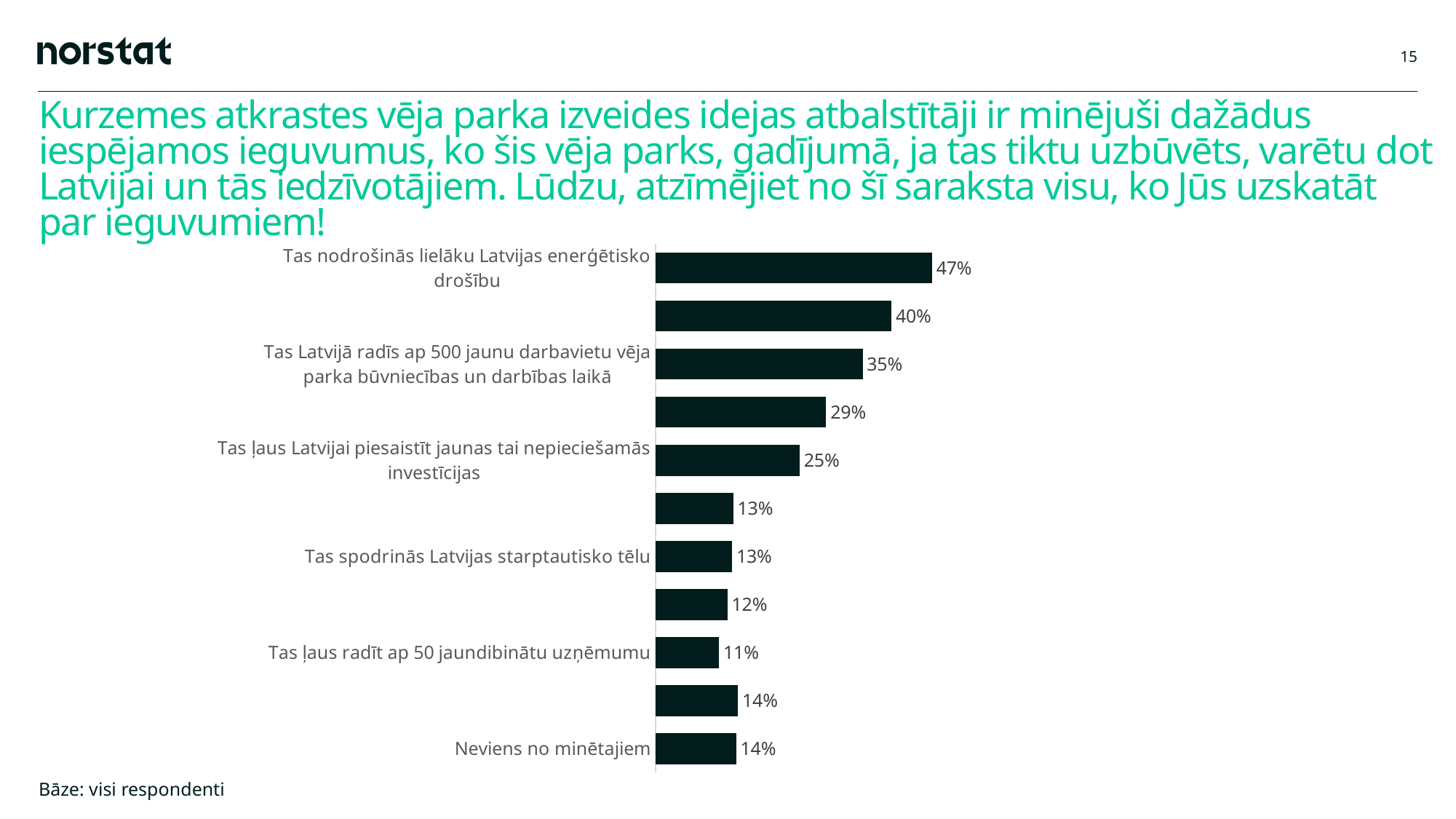
What is the value for "Tas ļaus radīt ap 50 jaundibinātu uzņēmumu"? 11% What is the value for "Tas Latvijā radīs ap 500 jaunu darbavietu vēja parka būvniecības un darbības laikā"? 35% Which category has the lowest value in the chart? Tas ļaus radīt ap 50 jaundibinātu uzņēmumu What percentage of respondents chose "Neviens no minētajiem"? 14% What kind of chart is shown on the slide? bar chart How many bars are plotted in the chart? 11 What is the value for "Tas ļaus Latvijai piesaistīt jaunas tai nepieciešamās investīcijas"? 25% What is the difference in percentage points between "Tas nodrošinās lielāku Latvijas enerģētisko drošību" and "Tas Latvijā radīs ap 500 jaunu darbavietu vēja parka būvniecības un darbības laikā"? 12 percentage points What percentage of respondents chose "Tas nodrošinās lielāku Latvijas enerģētisko drošību"? 47% What percentage is shown for "Tas spodrinās Latvijas starptautisko tēlu"? 13% Which is larger: the value for "Tas ļaus Latvijai piesaistīt jaunas tai nepieciešamās investīcijas" or for "Neviens no minētajiem"? Tas ļaus Latvijai piesaistīt jaunas tai nepieciešamās investīcijas Which category has the highest value in the chart? Tas nodrošinās lielāku Latvijas enerģētisko drošību